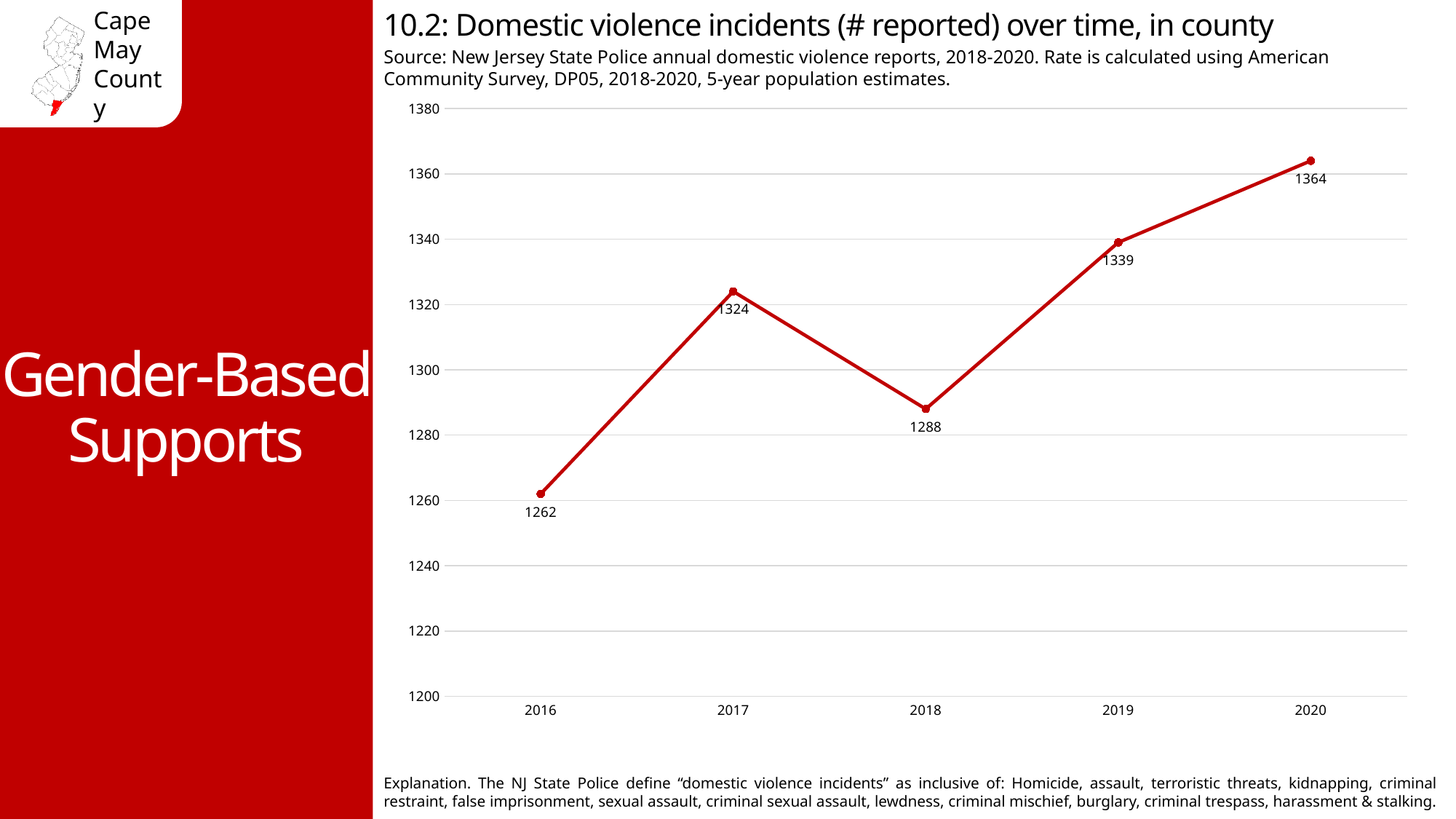
Which year had more reported incidents, 2017 or 2019? 2019 What is the number of reported domestic violence incidents in 2018? 1288 Did the number of reported incidents rise or fall from 2018 to 2020? rise How many years are plotted on the chart? 5 Is the value for 2018 greater or less than 1300? less Which year has the highest number of reported domestic violence incidents? 2020 What is the number of reported domestic violence incidents in 2016? 1262 What is the difference in reported incidents between 2017 and 2018? 36 What is the number of reported domestic violence incidents in 2020? 1364 What kind of chart is shown on the slide? line chart Which year has the lowest number of reported domestic violence incidents? 2016 What is the difference in reported incidents between 2020 and 2016? 102